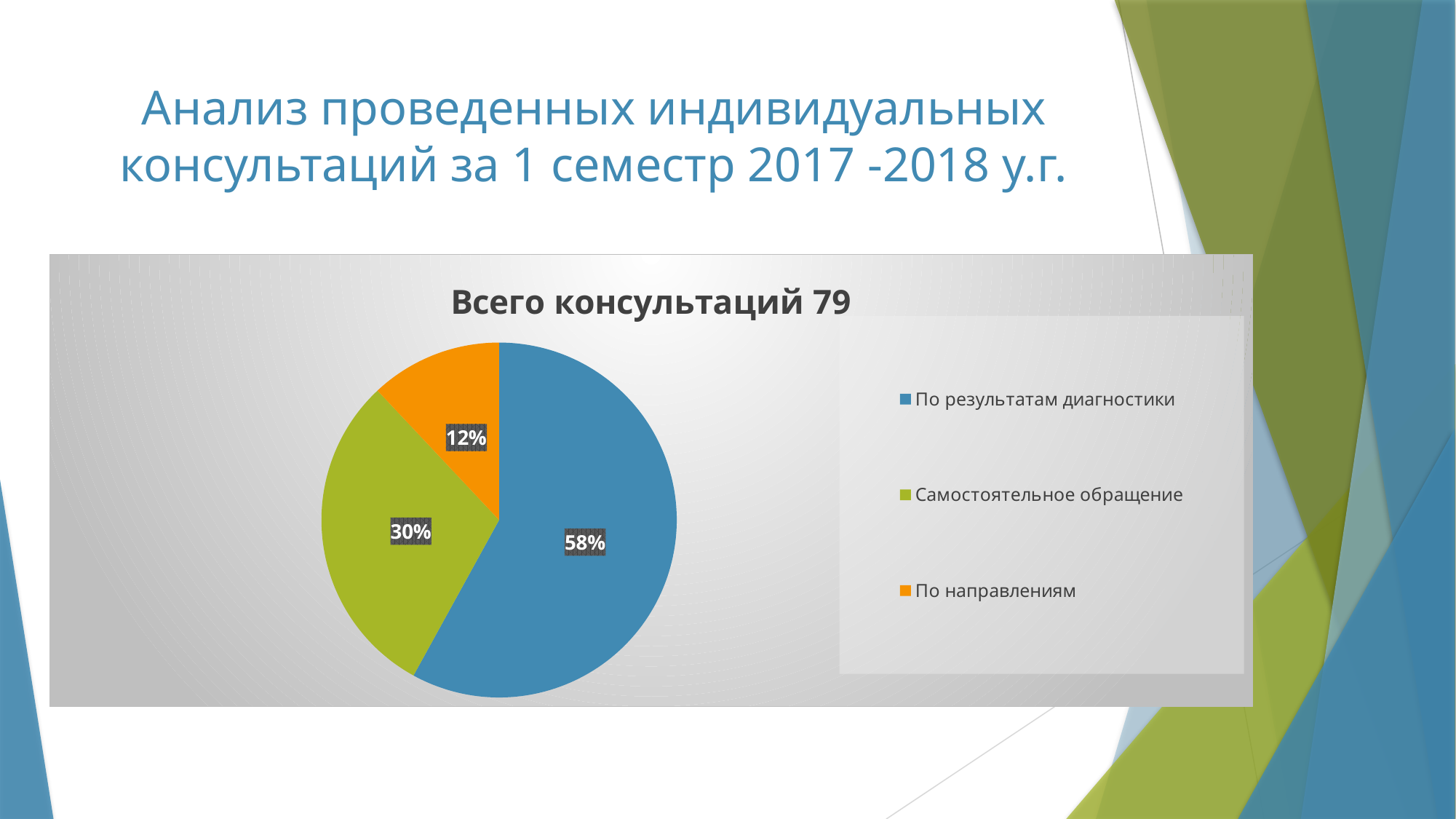
What is the difference in percentage points between "По результатам диагностики" and "Самостоятельное обращение"? 28 What share of the pie does "По результатам диагностики" take? 58% Which category has the largest slice of the pie? По результатам диагностики Which category has the smallest slice of the pie? По направлениям How many categories does the pie chart show? 3 What colour is the slice for "По направлениям"? orange What is the difference in percentage points between "Самостоятельное обращение" and "По направлениям"? 18 What is the title of the chart? Всего консультаций 79 Which is larger: the share for "Самостоятельное обращение" or the share for "По направлениям"? Самостоятельное обращение What share of the pie does "По направлениям" take? 12% What share of the pie does "Самостоятельное обращение" take? 30% What type of chart is shown on the slide? pie chart